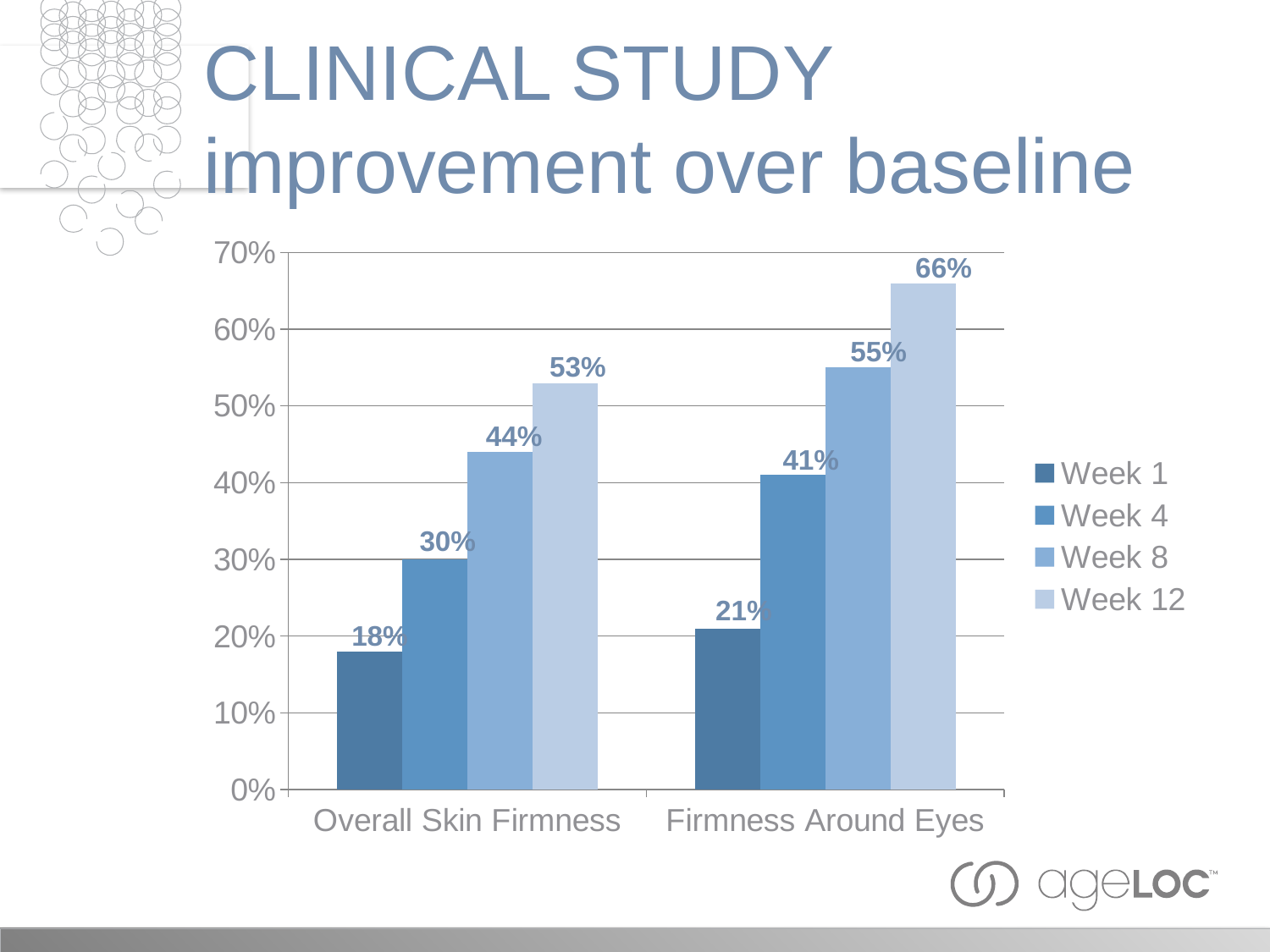
Which series has the lowest value for Overall Skin Firmness? Week 1 What is the difference between the Week 12 and Week 1 values for Firmness Around Eyes? 45% Which is larger: the Week 8 value for Overall Skin Firmness or the Week 4 value for Firmness Around Eyes? Week 8 value for Overall Skin Firmness What is the Week 12 value for Overall Skin Firmness? 53% Do the values for Firmness Around Eyes rise or fall from Week 1 to Week 12? Rise Which category has the highest Week 12 value? Firmness Around Eyes What is the Week 8 value for Firmness Around Eyes? 55% What is the Week 1 value for Firmness Around Eyes? 21% What kind of chart is shown on the slide? Bar chart How many categories are shown on the x axis? 2 What is the difference between the Week 4 values for Firmness Around Eyes and Overall Skin Firmness? 11% How many series does the legend list? 4